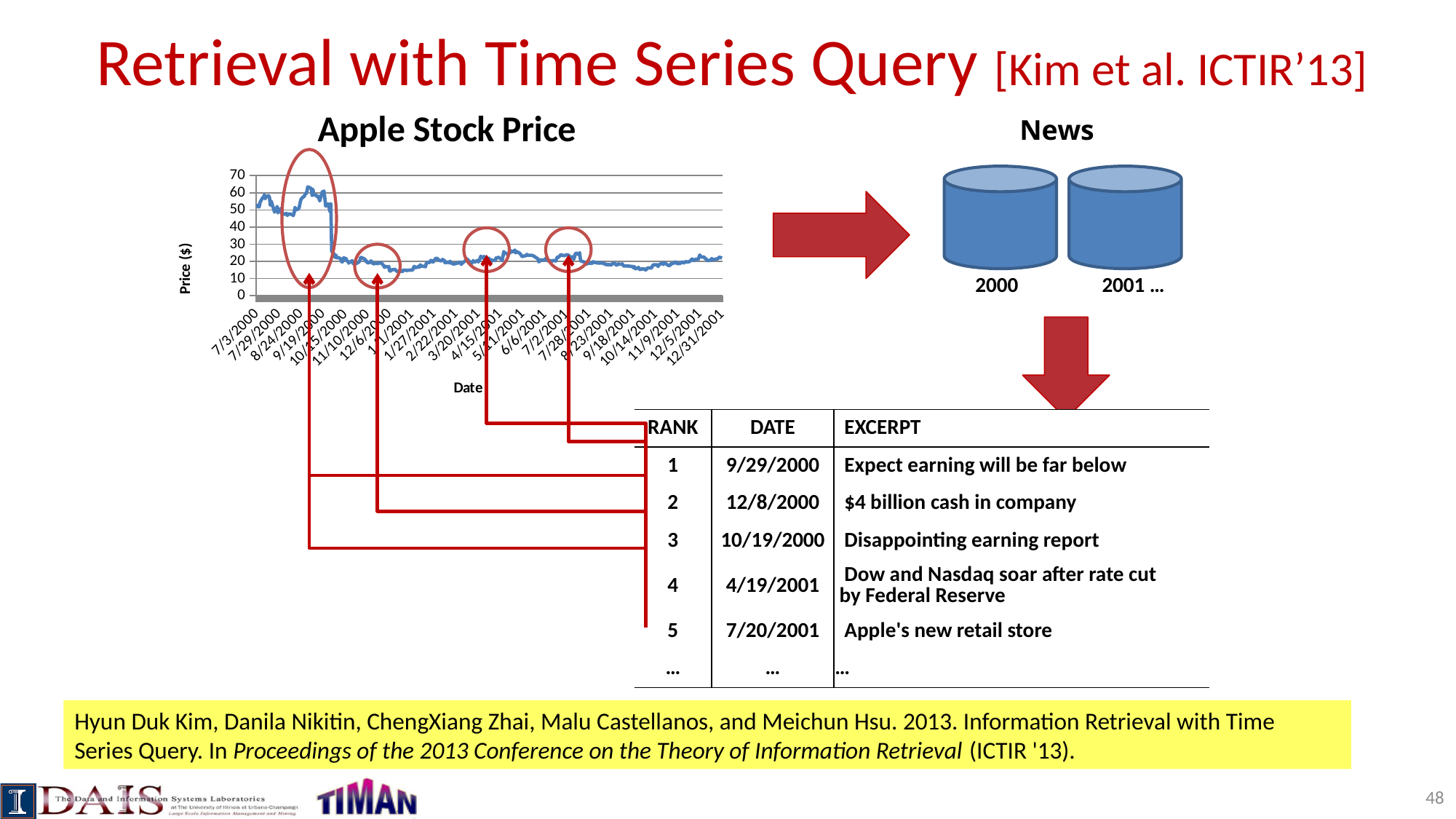
In the Apple Stock Price chart, is the value at 4/15/2001 greater or less than 40? less What is the highest tick value shown on the y axis of the Apple Stock Price chart? 70 In the Apple Stock Price chart, is the value at 10/15/2000 greater or less than 30? less In the Apple Stock Price chart, is the price at 7/3/2000 higher or lower than the price at 12/31/2001? higher What kind of chart is the Apple Stock Price chart? line chart In the Apple Stock Price chart, is the value around 8/24/2000 greater or less than 50? greater In the Apple Stock Price chart, does the price rise or fall between 9/19/2000 and 10/15/2000? fall How many date labels are shown on the x axis of the Apple Stock Price chart? 22 What is the label of the y axis of the Apple Stock Price chart? Price ($) What is the title of the chart on the left of the slide? Apple Stock Price